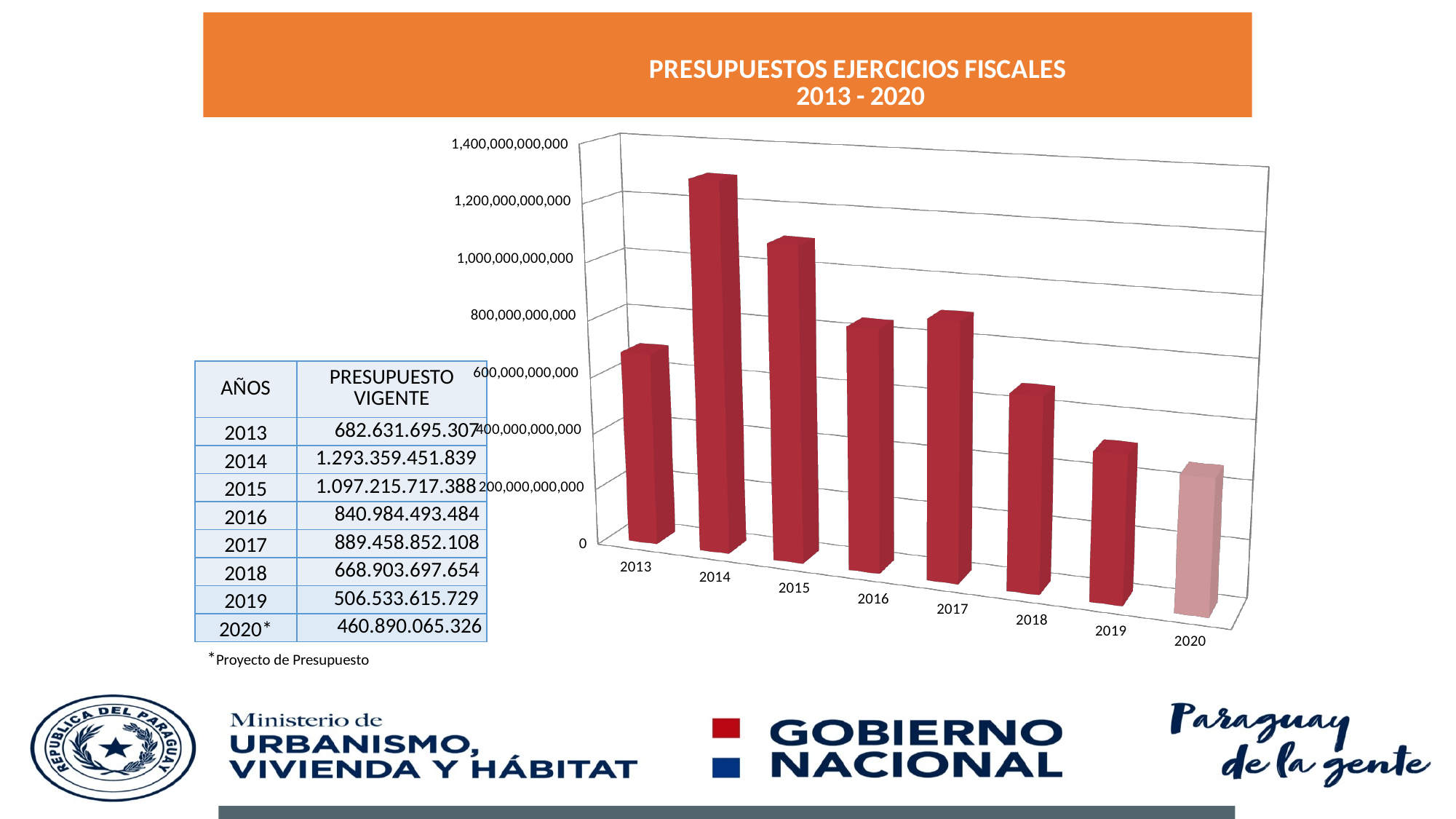
What is the difference between the 2019 and 2020 budget values? 45.643.550.403 Which year has a larger budget, 2016 or 2017? 2017 Is the value for 2019 greater or less than 600,000,000,000? less Which year has the lowest budget in the chart? 2020 How many years are plotted in the chart? 8 From 2017 to 2020, do the budget values rise or fall? fall Which year has the highest budget in the chart? 2014 What is the PRESUPUESTO VIGENTE value for 2018? 668.903.697.654 What is the PRESUPUESTO VIGENTE value for 2014? 1.293.359.451.839 What is the difference between the 2014 and 2013 budget values? 610.727.756.532 What is the budget value shown for 2020? 460.890.065.326 What kind of chart is shown on the slide? bar chart